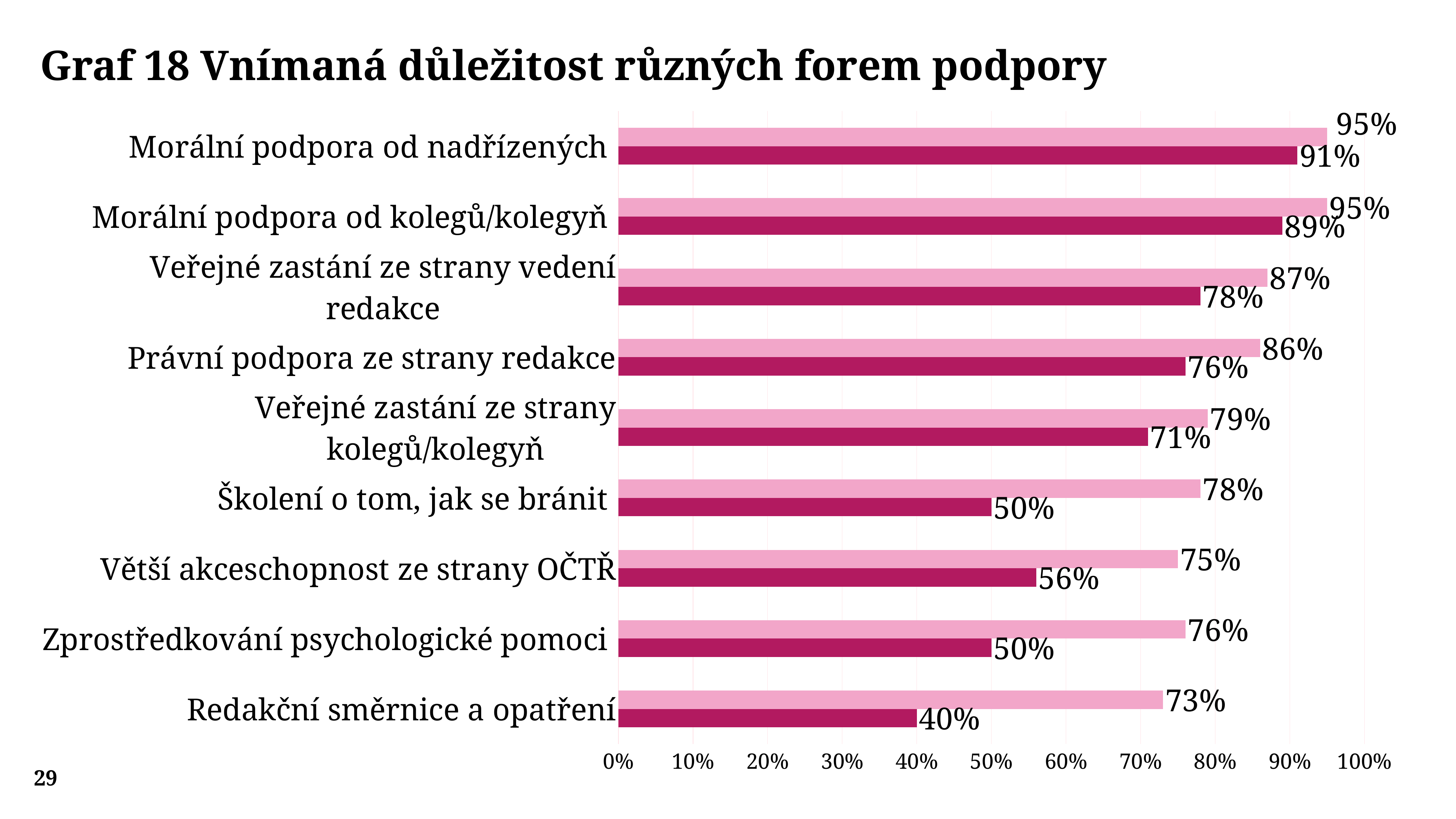
What is the value of the light pink bar for "Větší akceschopnost ze strany OČTŘ"? 75% Which category has the highest value for the dark magenta bar? Moralní podpora od nadřízených What is the title of the chart? Graf 18 Vnímaná důležitost různých forem podpory What type of chart is shown on the slide? bar chart What is the value of the light pink bar for "Moralní podpora od nadřízených"? 95% What is the value of the dark magenta bar for "Školení o tom, jak se bránit"? 50% How many categories are shown on the chart? 9 What is the difference between the light pink and dark magenta bars for "Školení o tom, jak se bránit"? 28% What is the difference between the light pink and dark magenta bars for "Redakční směrnice a opatření"? 33% Which category has the lowest value for the dark magenta bar? Redakční směrnice a opatření Which is larger: the dark magenta bar for "Větší akceschopnost ze strany OČTŘ" or the dark magenta bar for "Zprostředkování psychologické pomoci"? Větší akceschopnost ze strany OČTŘ What is the value of the dark magenta bar for "Redakční směrnice a opatření"? 40%